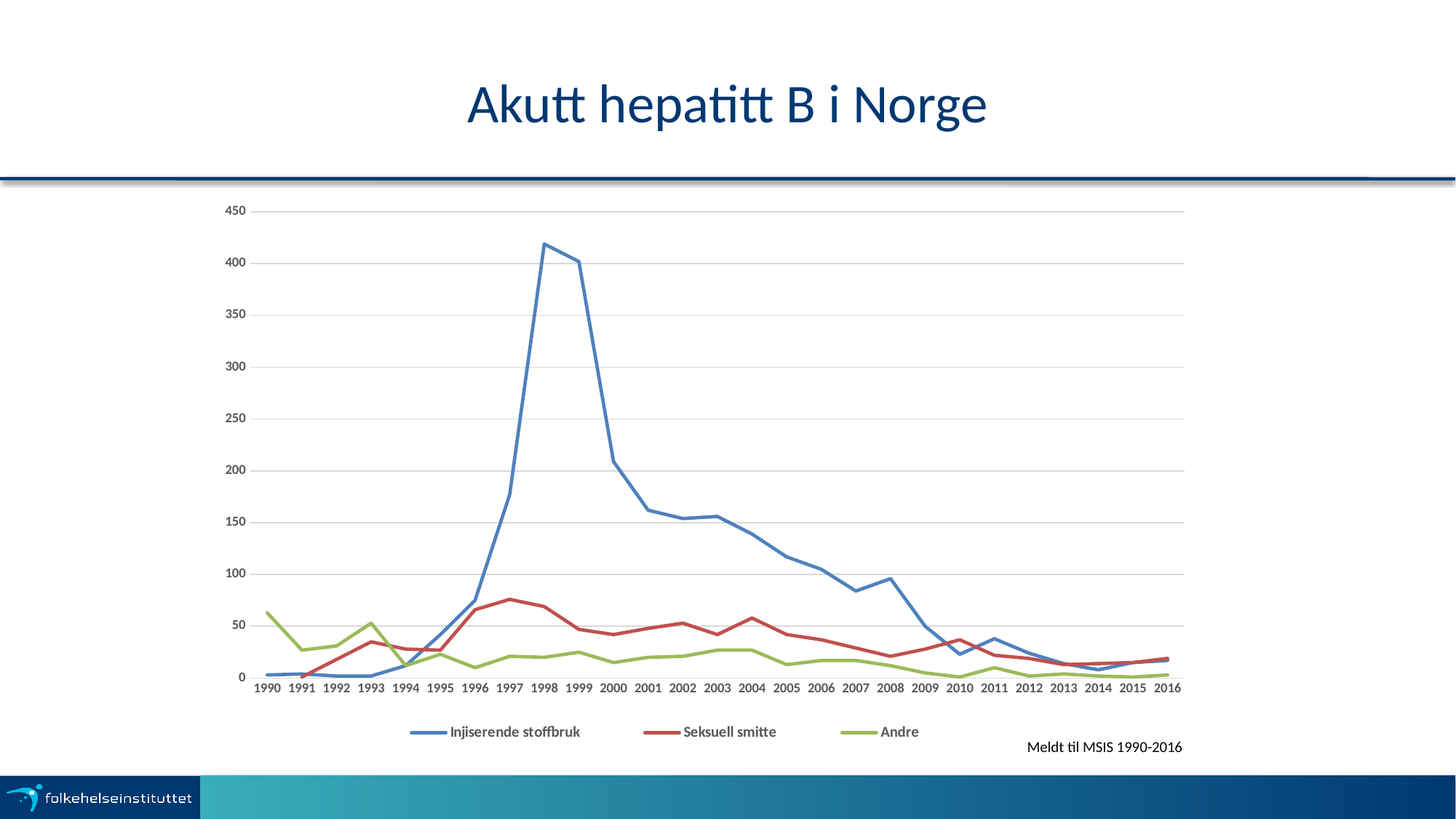
Is the value for Seksuell smitte in 1997 greater or less than 100? less In which year does the Andre series reach its highest value? 1990 Is the value for Injiserende stoffbruk in 1998 greater or less than 400? greater What kind of chart is shown on the slide? line chart How many series does the legend list? 3 Is the value for Injiserende stoffbruk in 1997 greater or less than 200? less Does the Injiserende stoffbruk series generally rise or fall from 1998 to 2016? fall How many years are plotted along the x axis? 27 In which year does the Injiserende stoffbruk series reach its highest value? 1998 In 2016, which series has the higher value, Seksuell smitte or Andre? Seksuell smitte In 1990, which series has the higher value, Andre or Injiserende stoffbruk? Andre What is the title of the slide containing the chart? Akutt hepatitt B i Norge